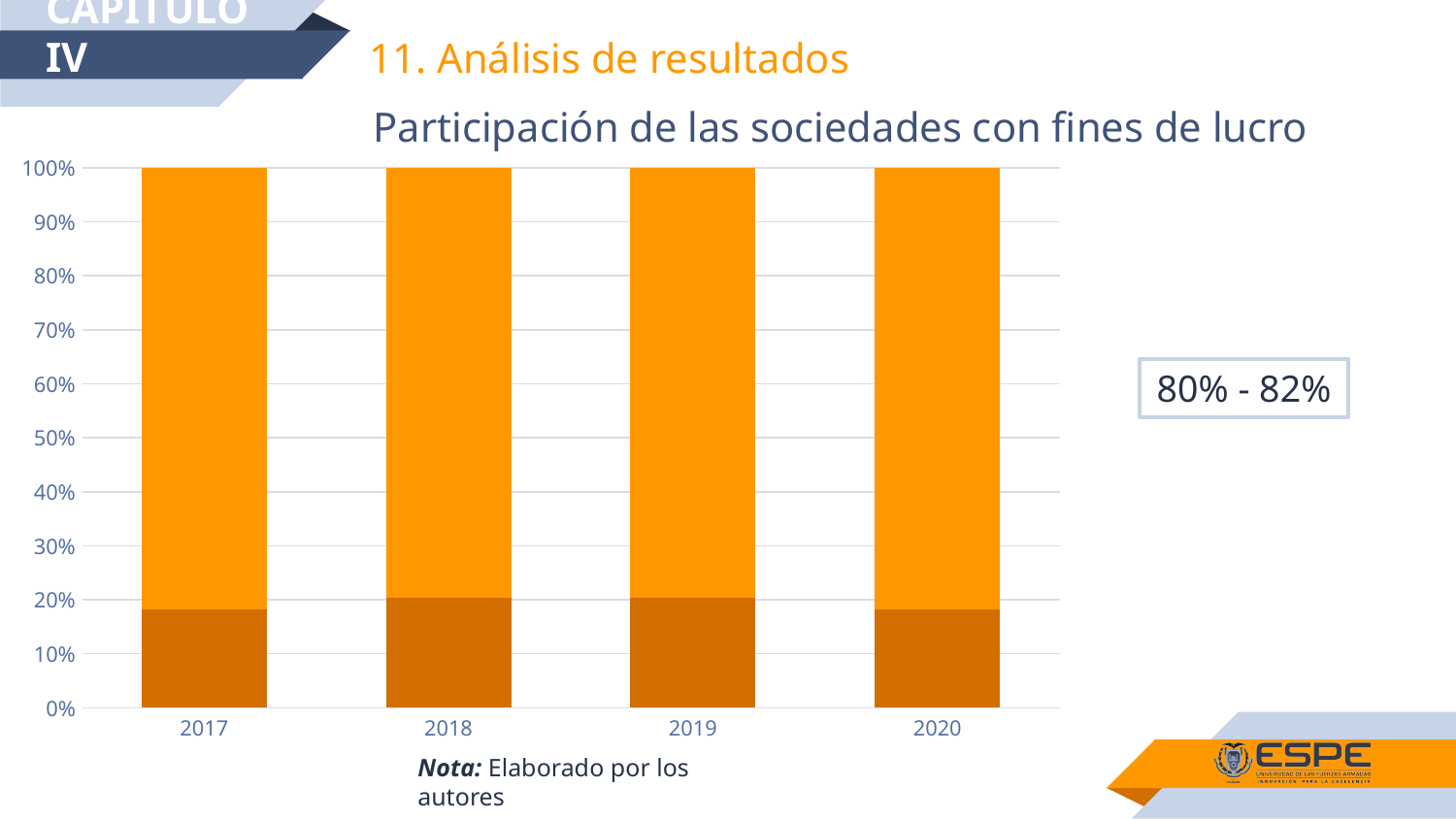
What kind of chart is shown on the slide? stacked bar chart What is the first year shown on the x axis of the chart? 2017 Is the value of the darker bottom segment for 2020 greater or less than 40%? less Is the value of the darker bottom segment for 2019 greater or less than 10%? greater What is the title of the chart? Participación de las sociedades con fines de lucro Is the value of the lighter top segment for 2018 greater or less than 70%? greater What is the total height of the stacked bar for 2020? 100% How many years are shown on the x axis of the chart? 4 What is the total height of the stacked bar for 2017? 100% What range is written in the text box to the right of the chart? 80% - 82% What is the highest value shown on the y axis of the chart? 100%